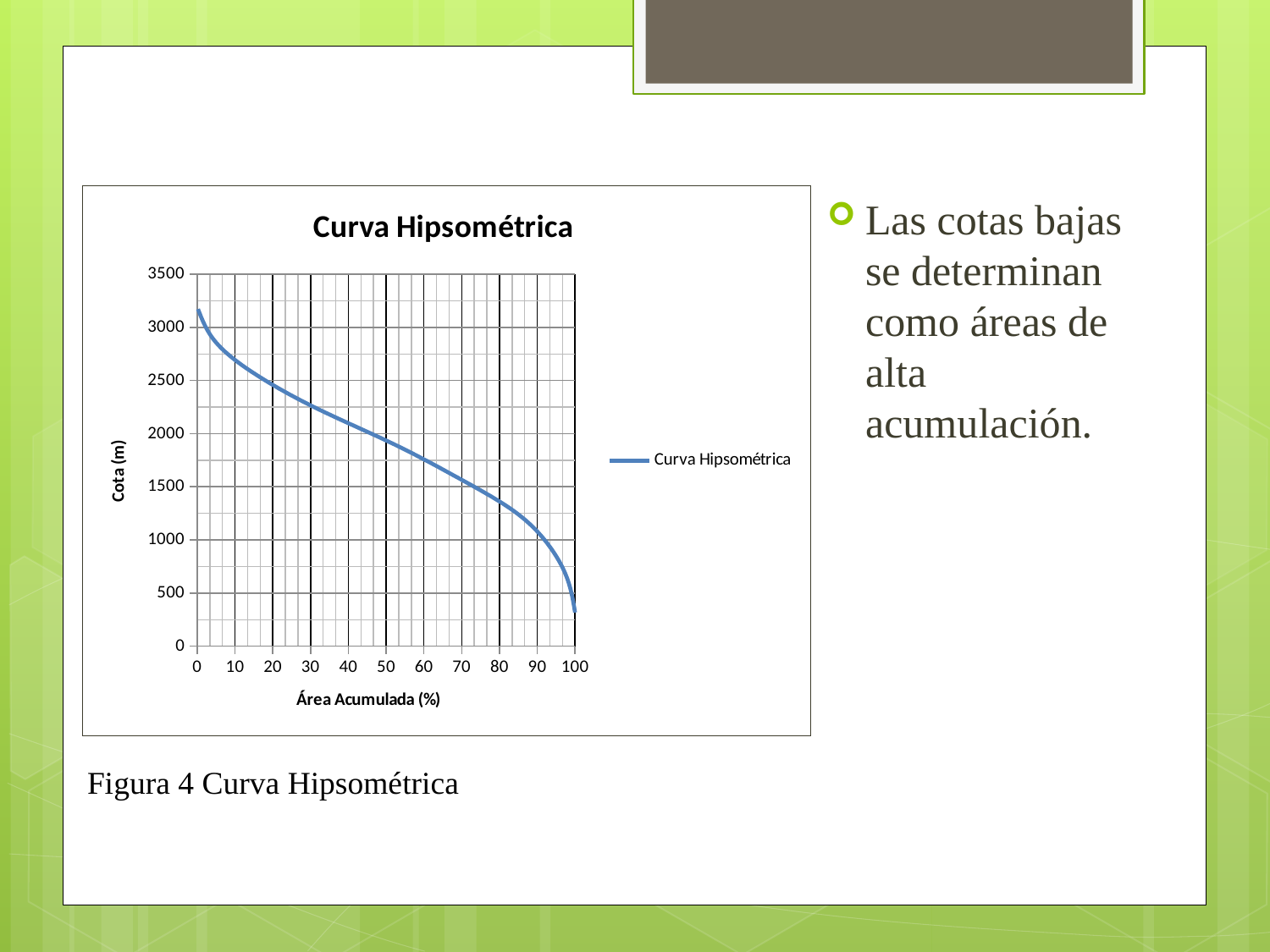
What is the title of the chart? Curva Hipsométrica Is the Cota (m) value at 0% Área Acumulada greater or less than 3000? greater Is the Cota (m) value at 60% Área Acumulada greater or less than 2000? less Which has the higher Cota (m) value: 20% or 80% Área Acumulada? 20% What kind of chart is shown on the slide? line chart Is the Cota (m) value at 10% Área Acumulada greater or less than 2500? greater How many series does the chart legend list? 1 Do the values of the curve rise or fall as Área Acumulada (%) increases? fall What is the label of the x axis? Área Acumulada (%)